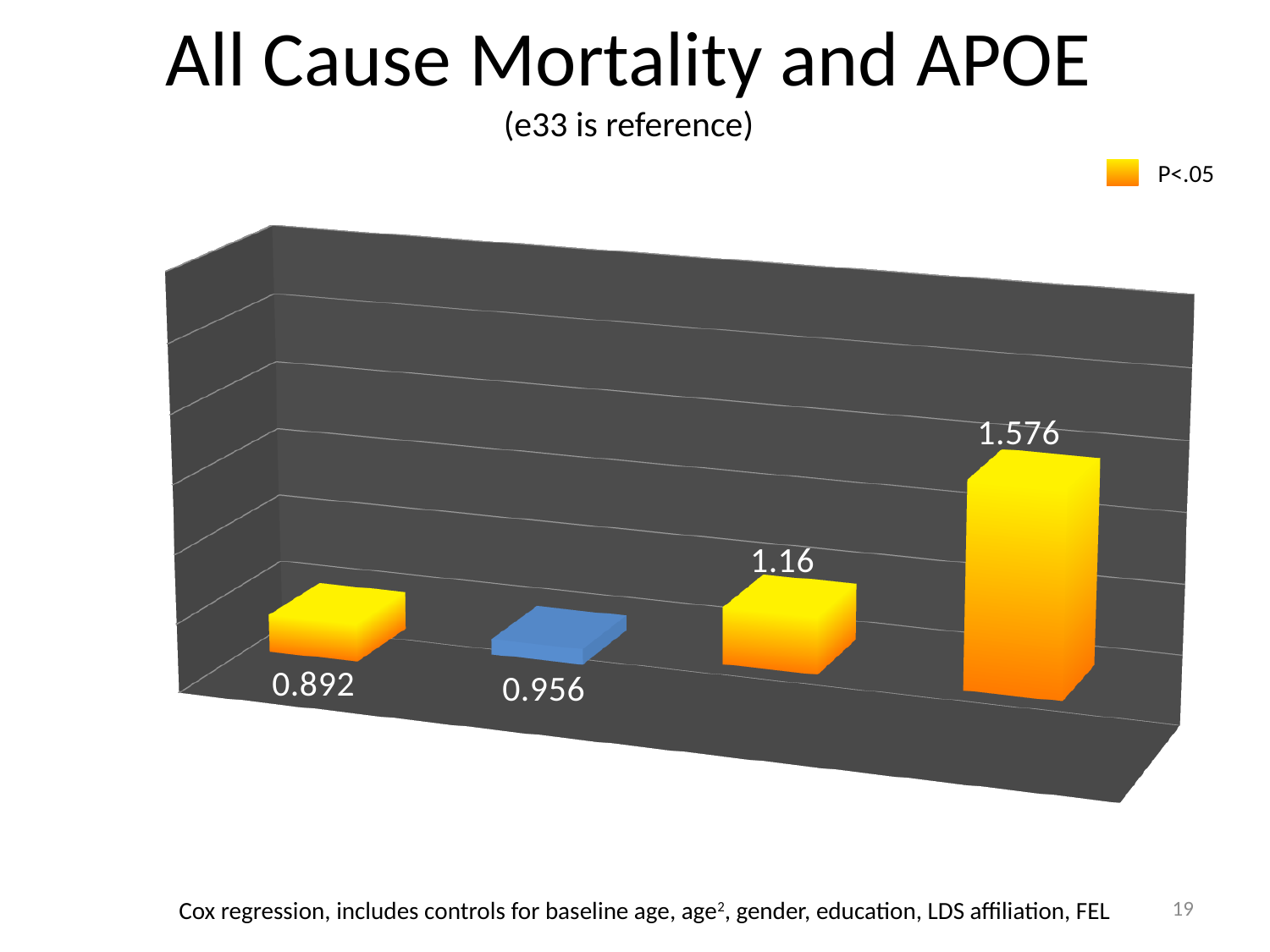
What does the legend entry with the yellow-orange swatch say? P<.05 What is the value shown on the rightmost (fourth) bar? 1.576 What is the highest value labelled in the chart? 1.576 What is the difference between the highest bar value (1.576) and the lowest bar value (0.892)? 0.684 What is the lowest value labelled in the chart? 0.892 How many bars are plotted in the chart? 4 What kind of chart is shown on the slide? bar chart What is the difference between the fourth bar (1.576) and the third bar (1.16)? 0.416 Which is larger, the value of the first bar or the value of the second bar? the second bar (0.956) What is the value shown on the leftmost (first) bar? 0.892 Do the bar values rise or fall from left to right across the chart? rise What is the value shown on the third bar from the left? 1.16